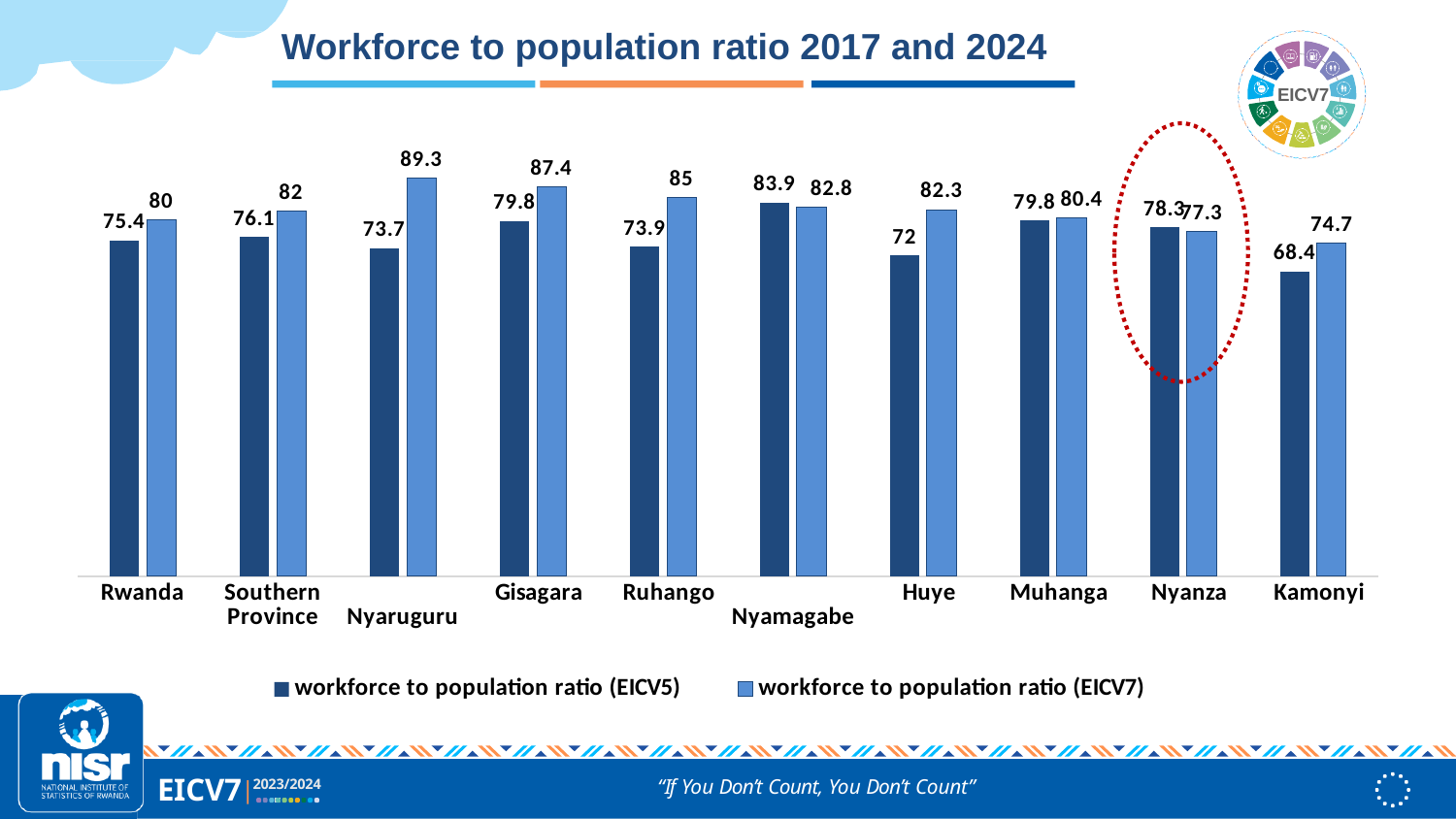
Which is larger for Nyanza: the EICV5 ratio or the EICV7 ratio? EICV5 ratio (78.3) What is the difference between the EICV7 and EICV5 workforce to population ratio for Nyaruguru? 15.6 How many categories are shown on the x axis? 10 Which category has the lowest workforce to population ratio (EICV5)? Kamonyi Which category has the highest workforce to population ratio (EICV7)? Nyaruguru What is the workforce to population ratio (EICV5) for Huye? 72 What kind of chart is shown on the slide? Bar chart What is the workforce to population ratio (EICV7) for Nyaruguru? 89.3 How many series does the legend list? 2 Which category is highlighted with a red dotted circle? Nyanza What is the title of the chart? Workforce to population ratio 2017 and 2024 What is the workforce to population ratio (EICV7) for Kamonyi? 74.7